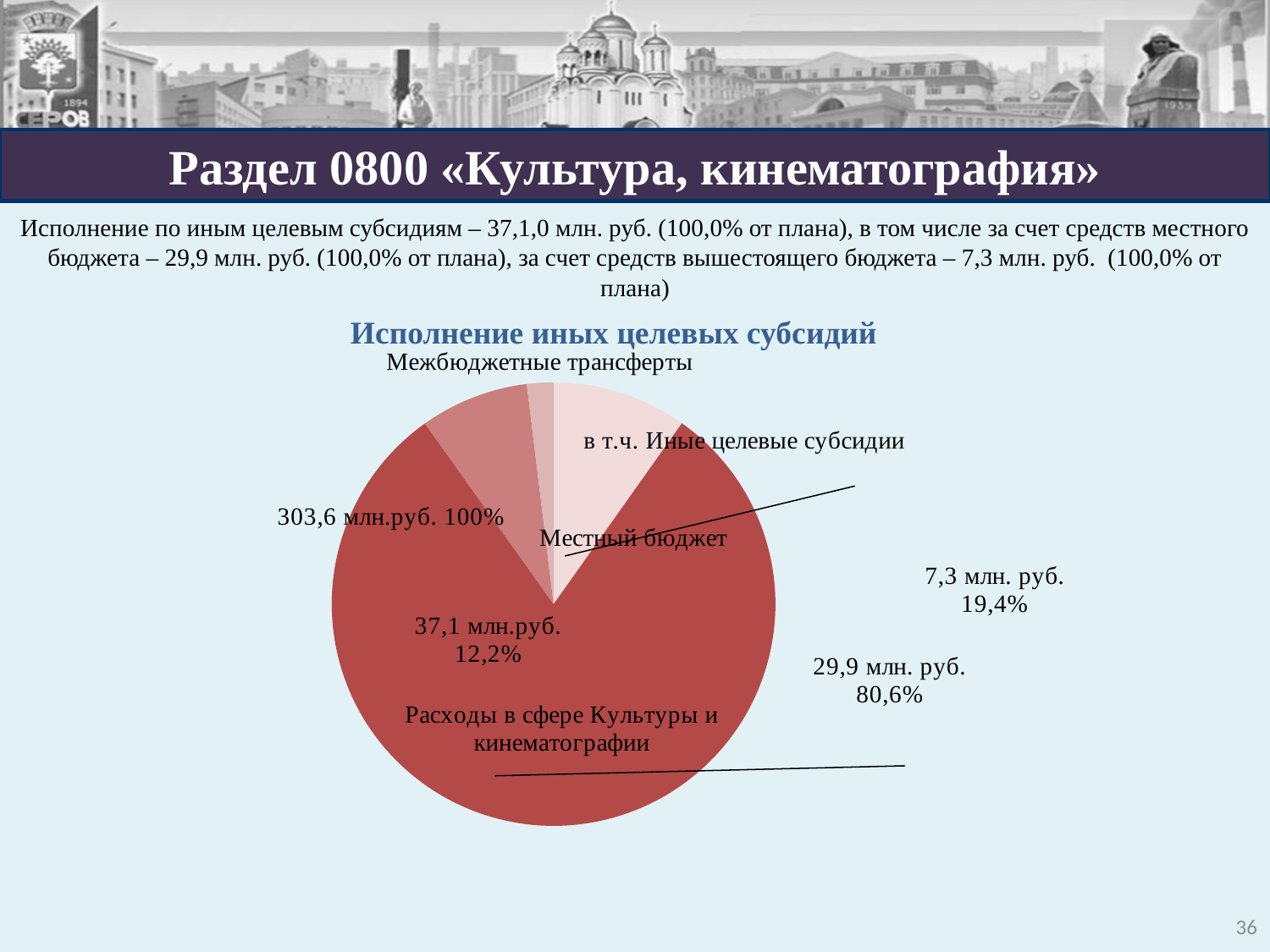
What percentage is shown next to «Местный бюджет»? 80,6% Which labelled item has the smallest value? Межбюджетные трансферты What value is shown for «Межбюджетные трансферты»? 7,3 млн. руб. What kind of chart is shown on the slide? pie chart What is the title of the chart? Исполнение иных целевых субсидий Which labelled item has the largest value? Расходы в сфере Культуры и кинематографии What percentage is shown next to «в т.ч. Иные целевые субсидии»? 12,2% Which is larger, «Местный бюджет» or «Межбюджетные трансферты»? Местный бюджет What value is shown for «в т.ч. Иные целевые субсидии»? 37,1 млн.руб. What value is shown for «Расходы в сфере Культуры и кинематографии»? 303,6 млн.руб. What value is shown for «Местный бюджет»? 29,9 млн. руб. What percentage is shown next to «Межбюджетные трансферты»? 19,4%